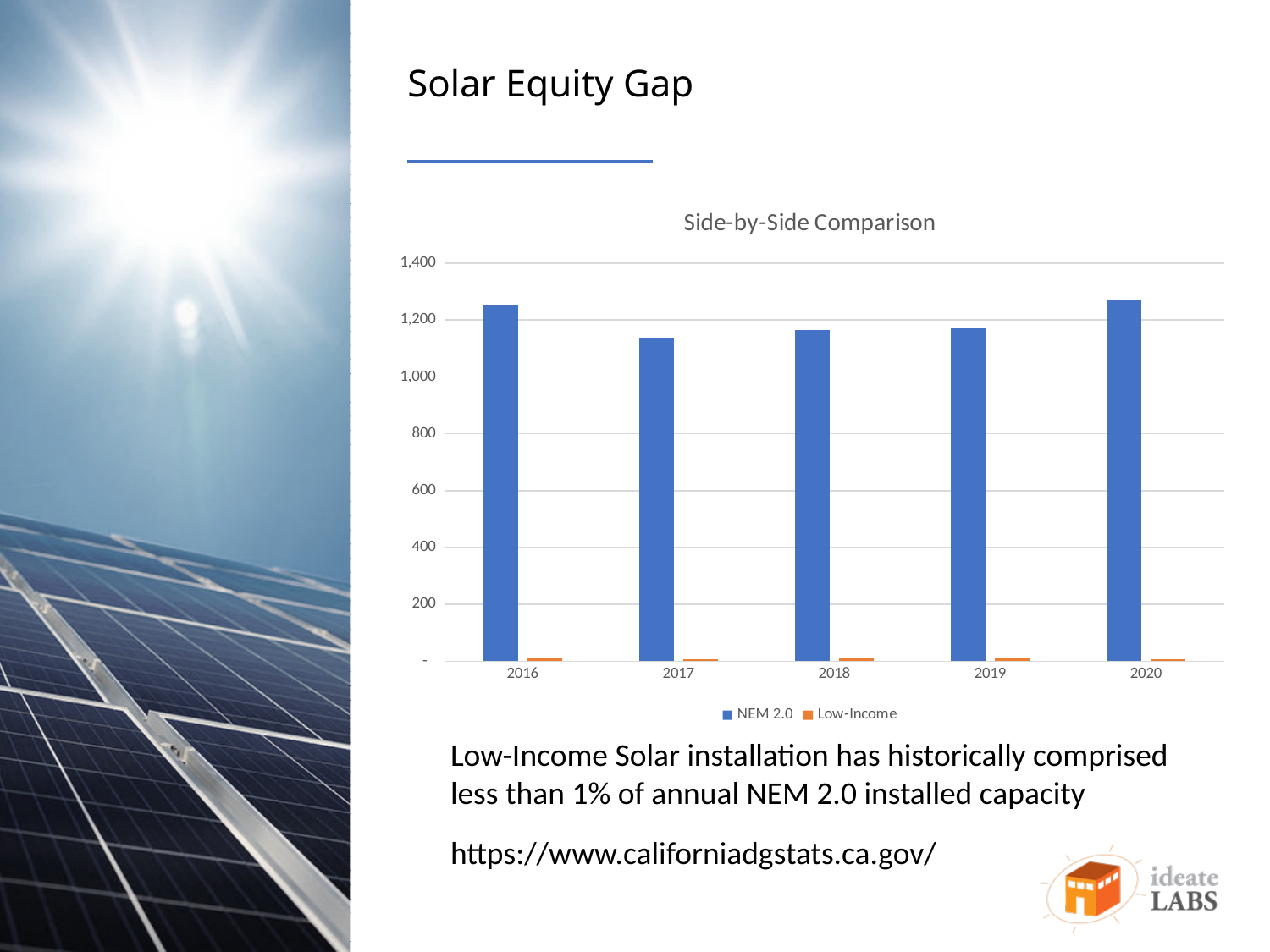
Which year has the highest NEM 2.0 value? 2020 Which year has the lowest NEM 2.0 value? 2017 What kind of chart is shown on the slide? bar chart Which series is shown in orange in the chart? Low-Income Is the NEM 2.0 value for 2017 greater or less than 1,200? less Which is larger, the NEM 2.0 value for 2016 or for 2017? 2016 How many years are shown on the x axis of the chart? 5 How many series does the chart legend list? 2 Is the NEM 2.0 value for 2016 greater or less than 1,200? greater In 2019, which series has the larger value, NEM 2.0 or Low-Income? NEM 2.0 What is the title of the chart? Side-by-Side Comparison Is the NEM 2.0 value for 2018 greater or less than 1,000? greater